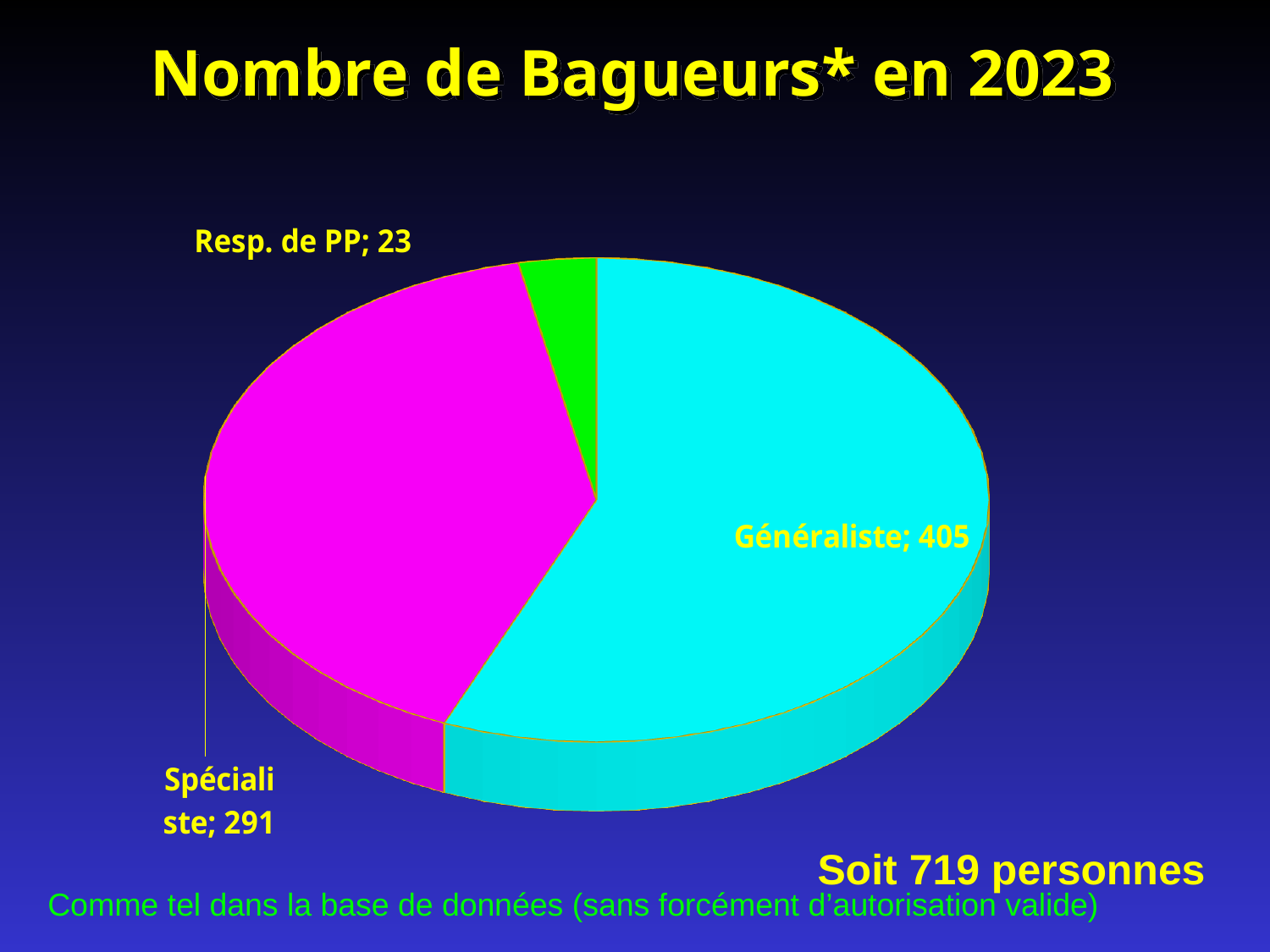
What is the value for Spécialiste? 291 What is the total number of persons across all slices, as stated on the slide? 719 Which category has the smallest slice? Resp. de PP Which is larger, Spécialiste or Resp. de PP? Spécialiste How many slices does the pie chart have? 3 Which category has the largest slice? Généraliste What is the title of the chart? Nombre de Bagueurs* en 2023 What type of chart is shown on the slide? Pie chart What is the value for Généraliste? 405 What is the difference between the Généraliste and Spécialiste values? 114 What is the value for Resp. de PP? 23 What colour is the Généraliste slice? Cyan